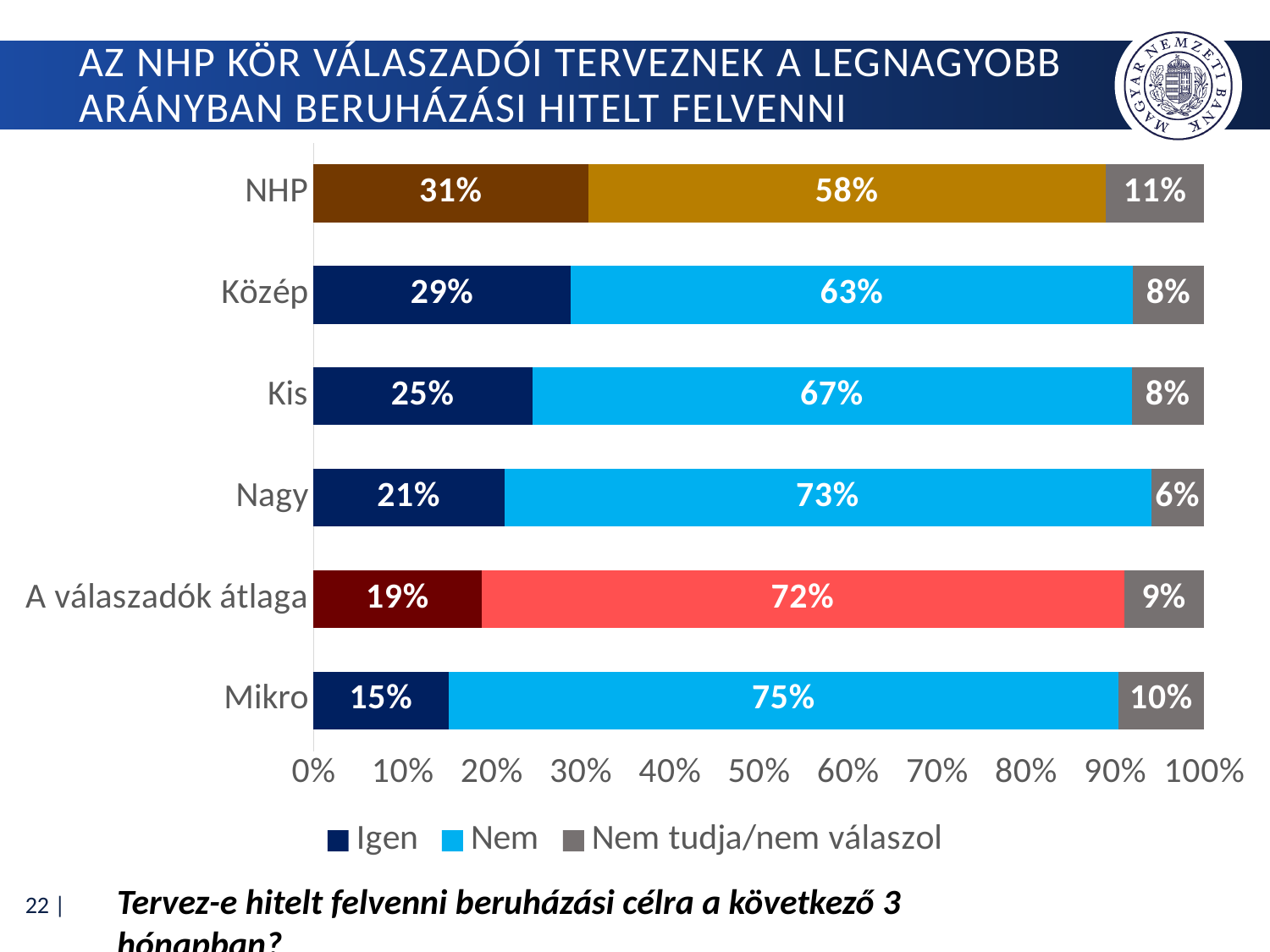
What is the total of the stacked bar for A válaszadók átlaga? 100% How many series does the legend list? 3 Which category has the lowest "Igen" value? Mikro Which legend entry is shown in grey? Nem tudja/nem válaszol What is the difference between the "Nem" values for Nagy and NHP? 15% What kind of chart is shown on the slide? Stacked bar chart Which category has the highest "Igen" value? NHP What is the "Nem tudja/nem válaszol" value for Mikro? 10% What is the "Igen" value for NHP? 31% How many categories are shown on the chart? 6 What is the "Nem" value for Kis? 67% Which is larger, the "Igen" value for Közép or the "Igen" value for Kis? Közép